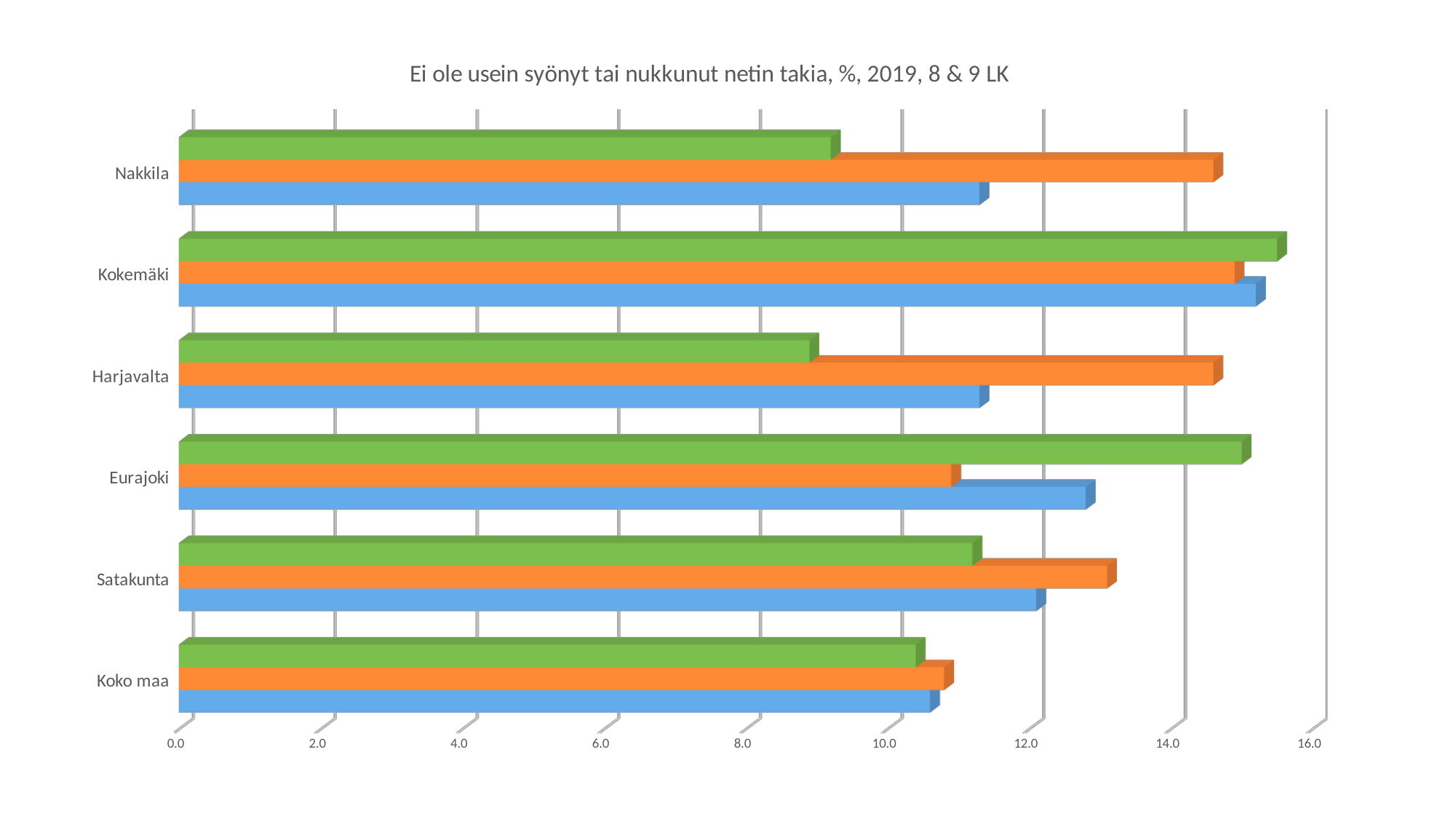
For Harjavalta, which is larger: the orange bar or the blue bar? the orange bar Is the orange bar for Nakkila greater or less than 14.0? greater Is the green bar for Kokemäki greater or less than 14.0? greater For Eurajoki, which is larger: the green bar or the orange bar? the green bar Is the green bar for Nakkila greater or less than 10.0? less Which category has the longest blue bar? Kokemäki How many bars are plotted for each category in the chart? 3 What kind of chart is shown on the slide? bar chart What is the title of the chart? Ei ole usein syönyt tai nukkunut netin takia, %, 2019, 8 & 9 LK How many categories (areas) are shown on the vertical axis of the chart? 6